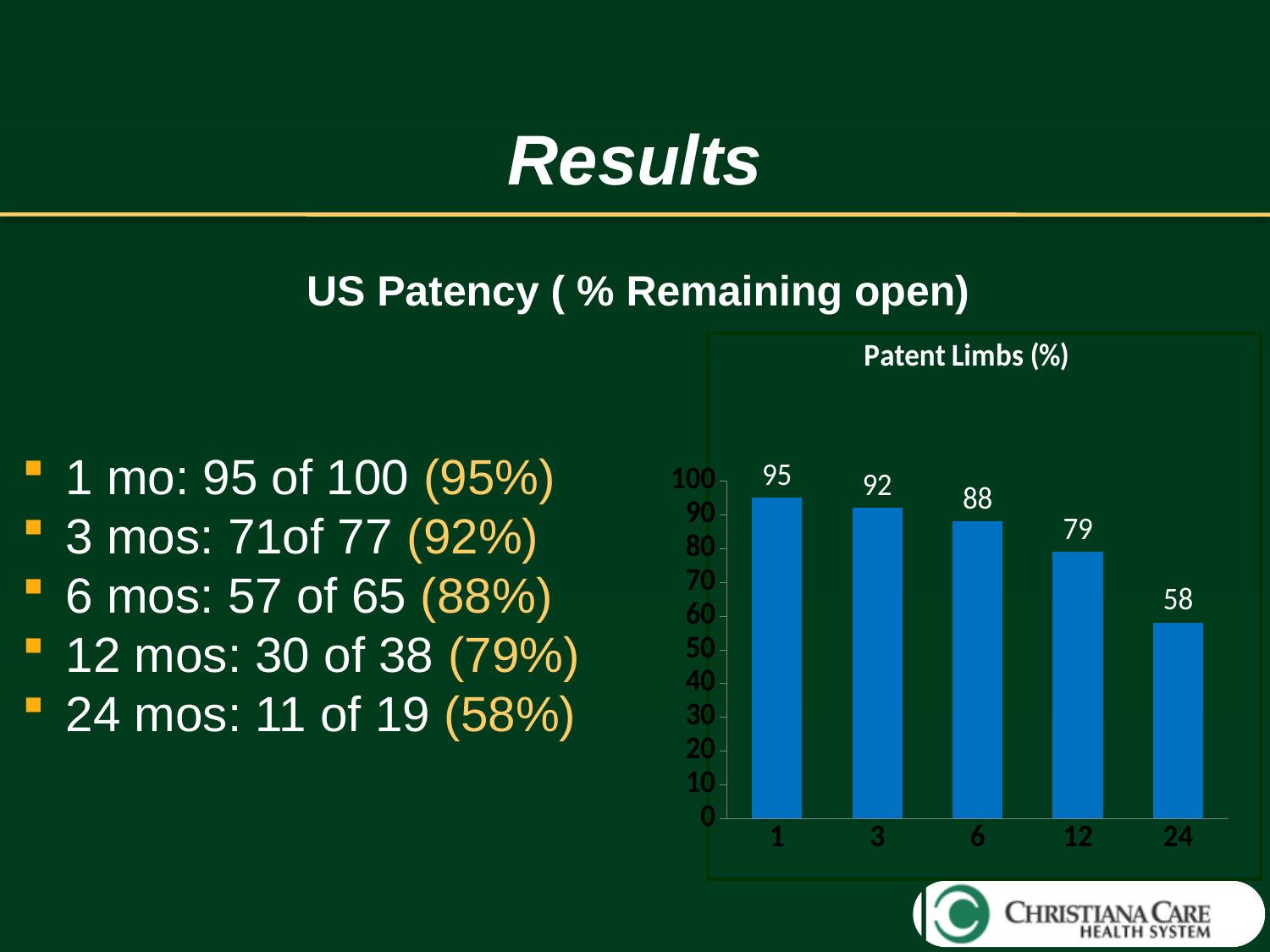
Do the values rise or fall from left to right along the x axis? fall Which category has the highest value in the Patent Limbs (%) chart? 1 What is the value for category 1 in the Patent Limbs (%) chart? 95 What is the value for category 12 in the Patent Limbs (%) chart? 79 Which is larger, the value for category 3 or the value for category 6? 3 Which category has the lowest value in the Patent Limbs (%) chart? 24 What kind of chart is shown on the slide? bar chart What is the difference between the values for category 1 and category 24? 37 What is the value for category 24 in the Patent Limbs (%) chart? 58 Is the value for category 12 greater or less than 70? greater How many categories are shown on the x axis of the chart? 5 What is the difference between the values for category 6 and category 12? 9